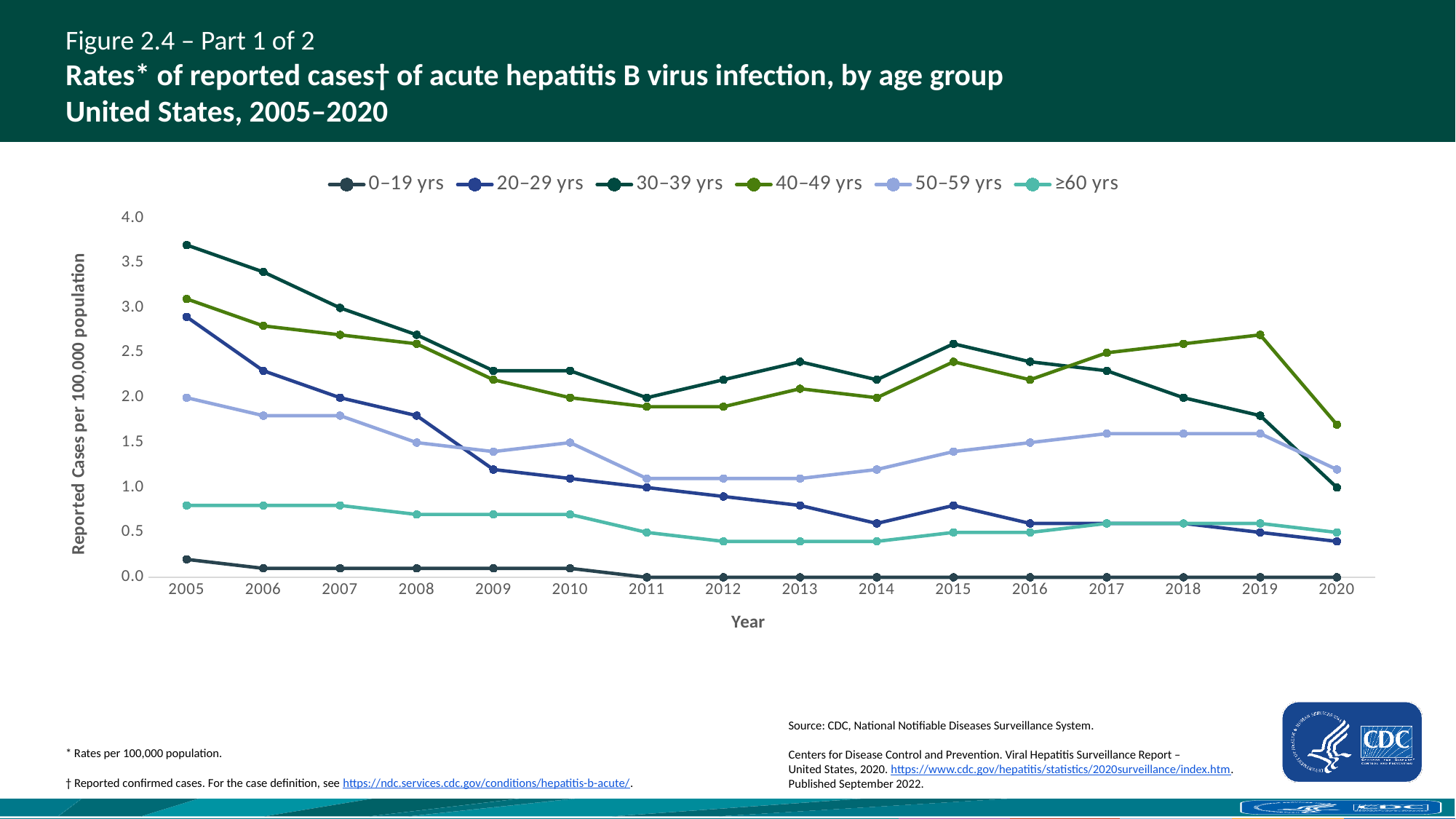
Which age group had the highest rate in 2020? 40–49 yrs What is the rate for the 0–19 yrs group in 2015? 0.0 What kind of chart is shown on the slide? line chart Does the rate for the 30–39 yrs group rise or fall overall from 2005 to 2020? fall Which age group had the highest rate in 2005? 30–39 yrs Is the rate for the 30–39 yrs group in 2005 greater or less than 3.5? greater Is the rate for the ≥60 yrs group in 2012 greater or less than 0.5? less Which age group had the lowest rate in 2005? 0–19 yrs In 2019, which group had the higher rate: 40–49 yrs or 20–29 yrs? 40–49 yrs How many age groups does the legend list? 6 How many years are plotted along the x axis? 16 What is the label of the y axis? Reported Cases per 100,000 population